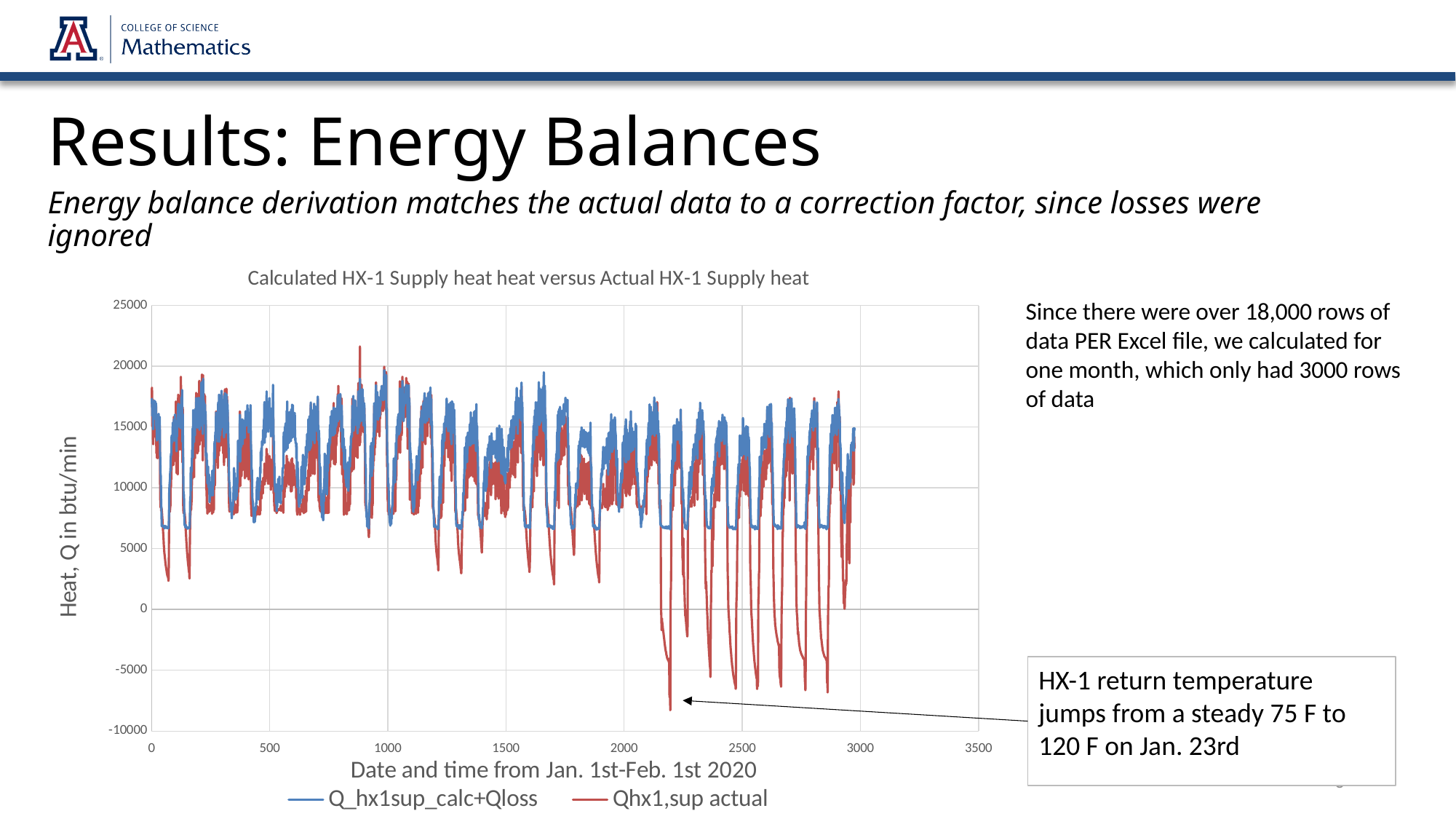
Is the highest value of the Q_hx1sup_calc+Qloss series greater or less than 15000? greater What are the two series named in the legend? Q_hx1sup_calc+Qloss and Qhx1,sup actual How many series does the legend list? 2 Which series reaches the lowest values on the chart, Q_hx1sup_calc+Qloss or Qhx1,sup actual? Qhx1,sup actual What is the label on the vertical axis of the chart? Heat, Q in btu/min Is the highest value of the Qhx1,sup actual series greater or less than 20000? greater Does the Q_hx1sup_calc+Qloss series ever drop below 0? no What kind of chart is shown on the slide? line chart Which series has the higher minimum value, Q_hx1sup_calc+Qloss or Qhx1,sup actual? Q_hx1sup_calc+Qloss